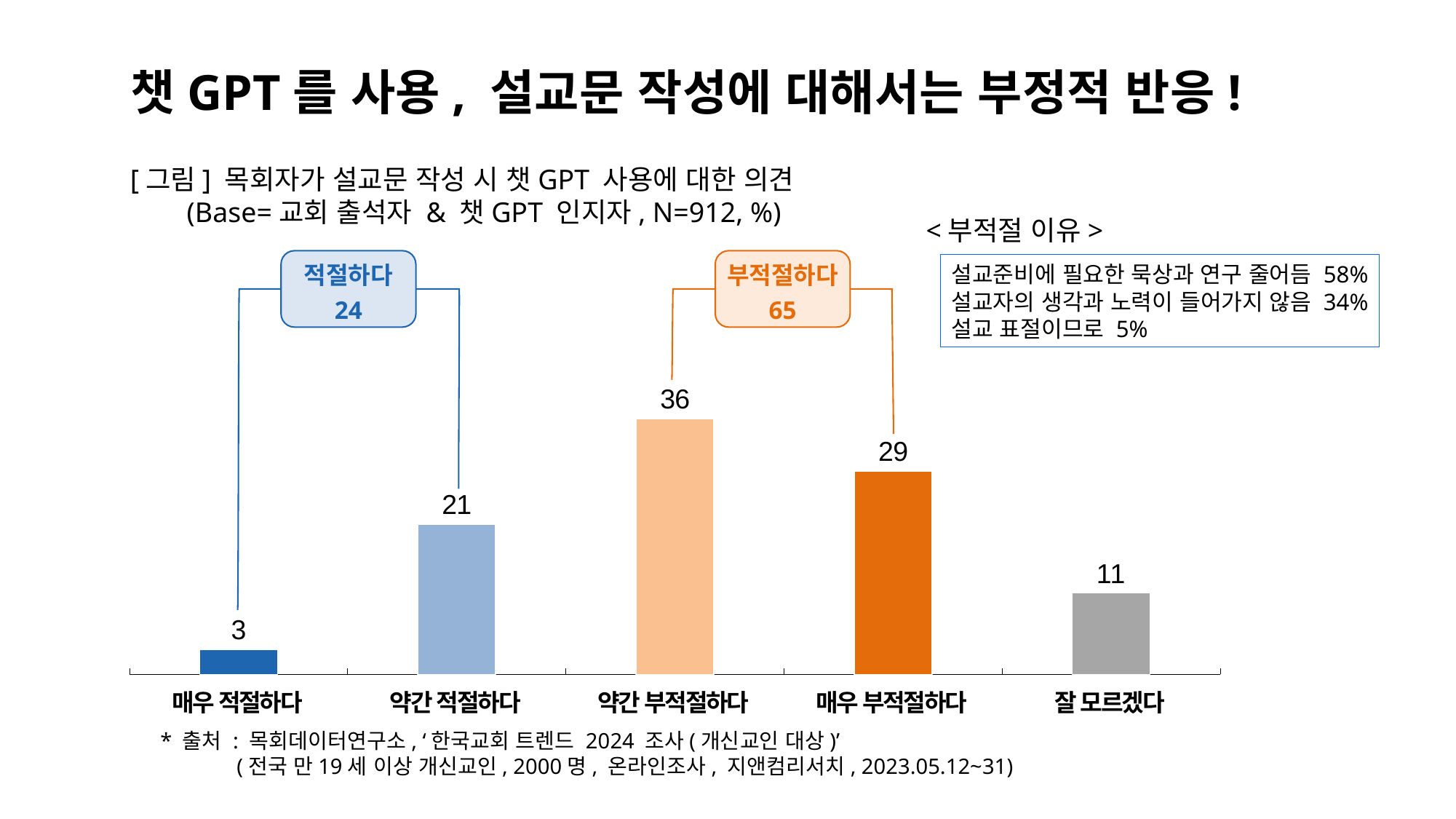
What is the value for 약간 부적절하다? 36 What is the combined value shown in the 부적절하다 bracket label? 65 Which is larger, the value for 약간 적절하다 or the value for 매우 부적절하다? 매우 부적절하다 Which category has the lowest value? 매우 적절하다 What kind of chart is this? bar chart What is the difference between the values for 약간 부적절하다 and 매우 부적절하다? 7 How many categories are shown on the x axis? 5 What is the value for 매우 적절하다? 3 Which category has the highest value? 약간 부적절하다 What is the sample size (N) stated in the chart caption? 912 What is the value for 잘 모르겠다? 11 What is the combined value shown in the 적절하다 bracket label? 24